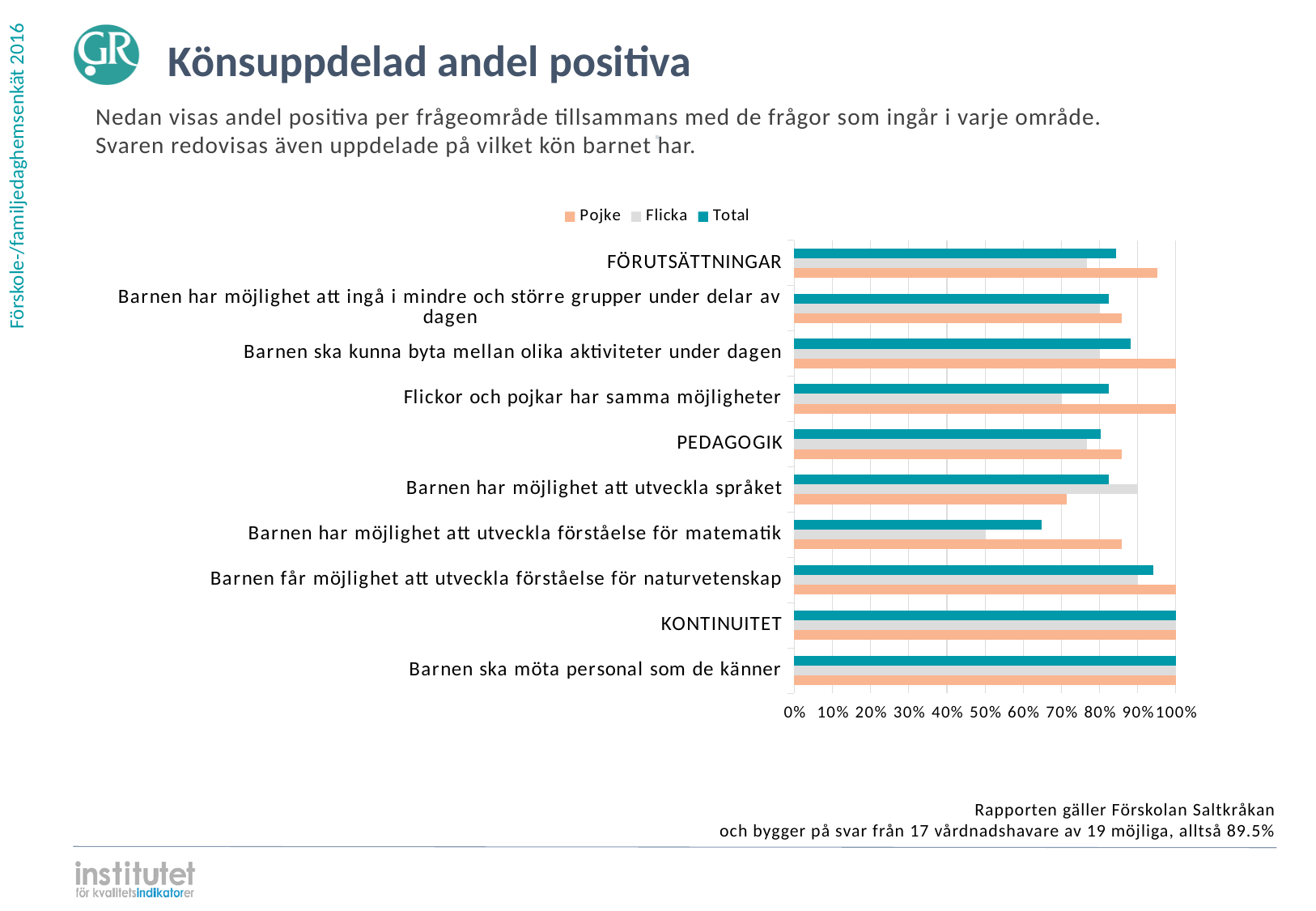
For 'Barnen har möjlighet att utveckla språket', which is larger: the Pojke value or the Flicka value? Flicka What is the Pojke value for 'Barnen ska möta personal som de känner'? 100% Is the Flicka value for FÖRUTSÄTTNINGAR greater or less than 80%? less Is the Pojke value for FÖRUTSÄTTNINGAR greater or less than 90%? greater Is the Total value for 'Barnen har möjlighet att utveckla förståelse för matematik' greater or less than 70%? less What is the Pojke value for 'Flickor och pojkar har samma möjligheter'? 100% How many series does the legend list? 3 What is the Total value for KONTINUITET? 100% Which category has the lowest Flicka value? Barnen har möjlighet att utveckla förståelse för matematik For 'Barnen har möjlighet att utveckla förståelse för matematik', which is larger: the Pojke value or the Flicka value? Pojke How many categories are shown on the chart? 10 What kind of chart is shown on the slide? bar chart